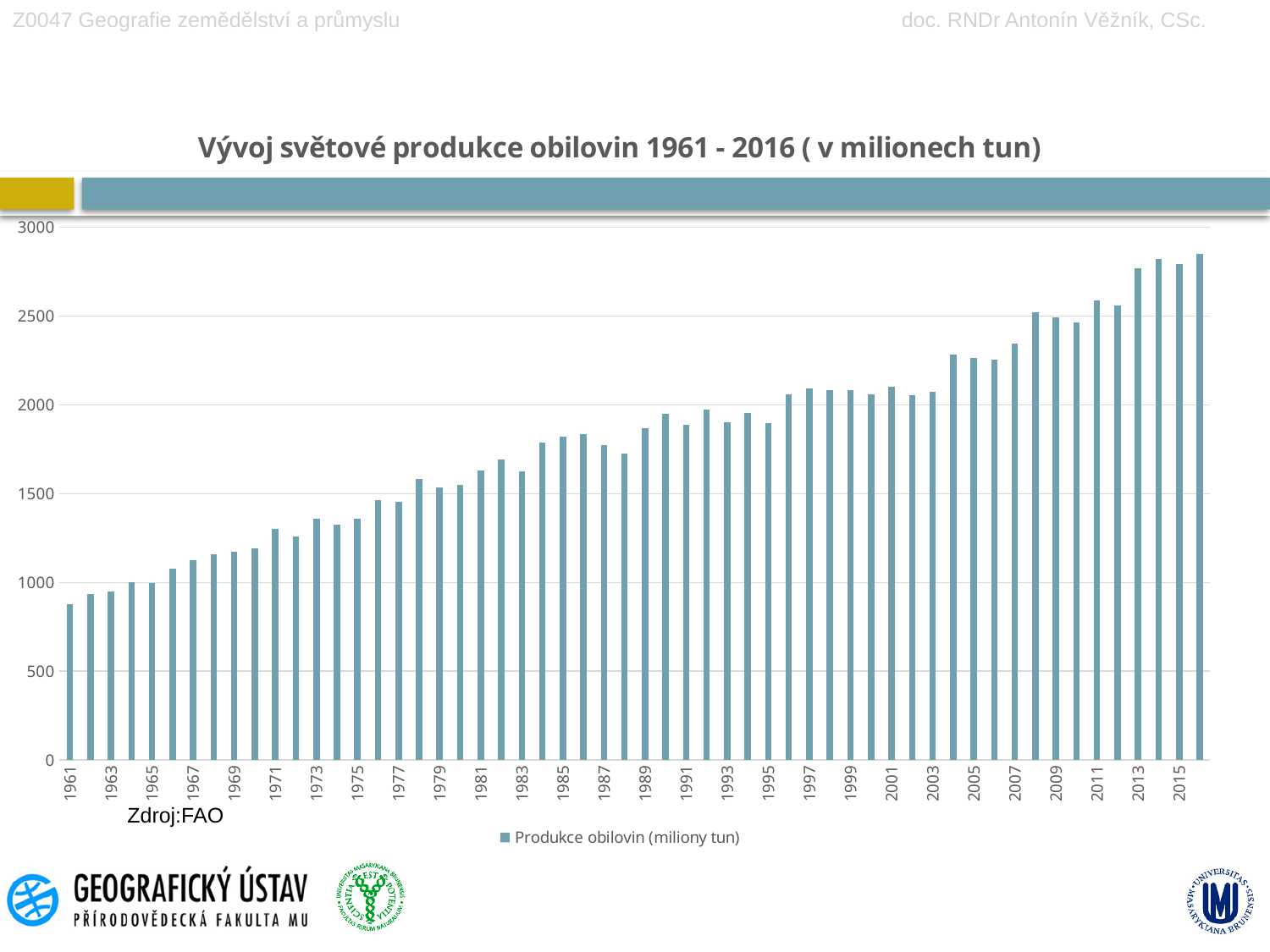
What kind of chart is shown on the slide? bar chart What is the title of the chart? Vývoj světové produkce obilovin 1961 - 2016 ( v milionech tun) How many series does the legend list? 1 Which year has the larger value, 1975 or 1995? 1995 Is the value for 2016 greater or less than 2500? greater Is the value for 1985 greater or less than 1500? greater Do the values generally rise or fall from 1961 to 2016? rise What is the legend entry for the plotted series? Produkce obilovin (miliony tun) Is the value for 1961 greater or less than 1000? less Which year has the highest cereal production? 2016 Which year has the lowest cereal production? 1961